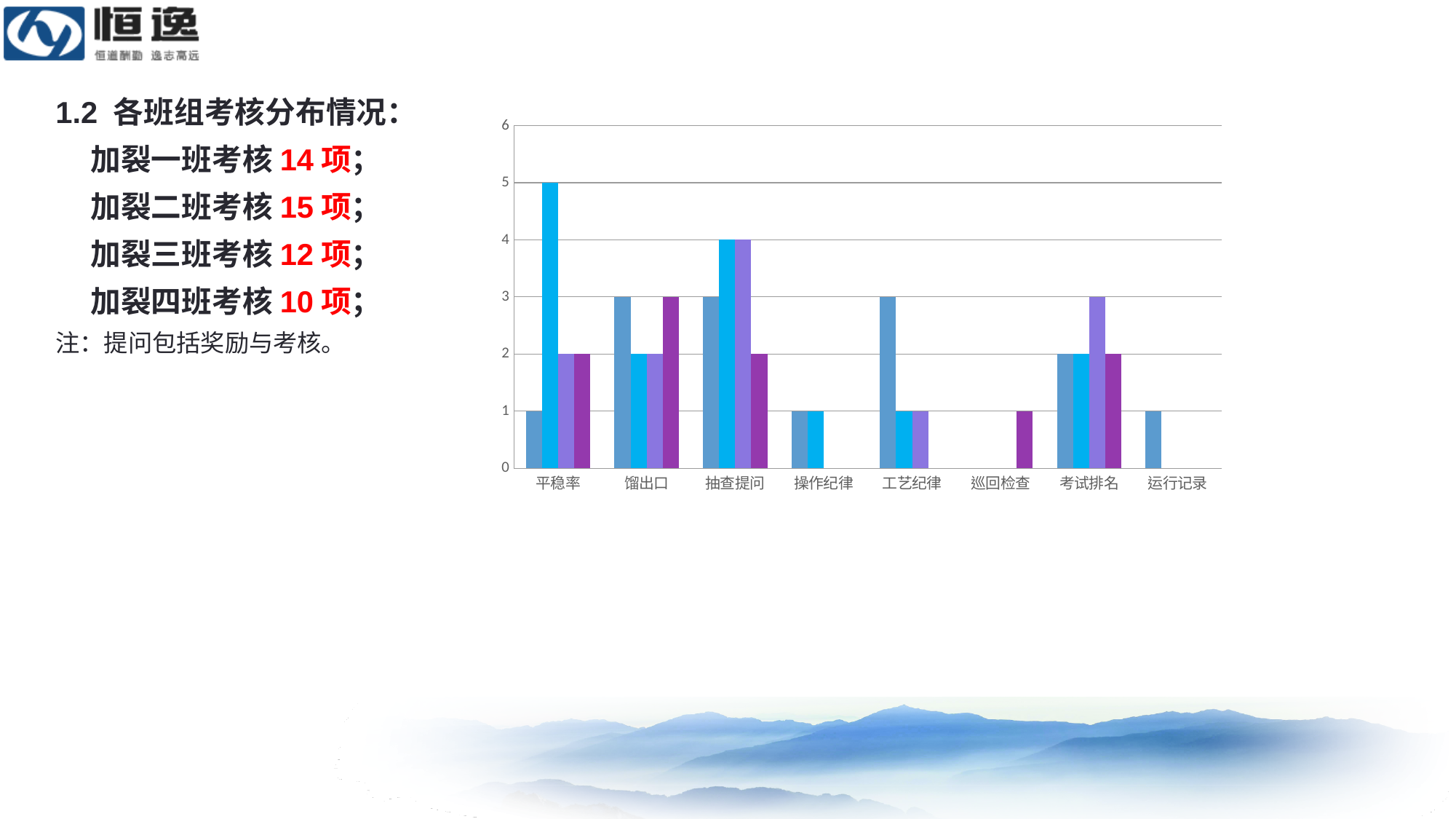
What is the value of the only bar shown in the 巡回检查 group? 1 What is the value of the first (steel blue) bar in the 工艺纪律 group? 3 What kind of chart is shown on the slide? bar chart How many categories are shown on the x axis of the chart? 8 What is the highest value reached by any bar in the chart, and in which category does it occur? 5, in 平稳率 Does the chart include a legend identifying the bar series? No What is the value of the tallest (cyan, second) bar in the 平稳率 group? 5 Is the value of the cyan (second) bar in the 平稳率 group greater or less than 4? greater What is the maximum value shown on the y axis of the chart? 6 What is the value of the only bar shown in the 运行记录 group? 1 What is the value of the third (lavender) bar in the 考试排名 group? 3 Which is larger: the first (steel blue) bar in 抽查提问 or the first (steel blue) bar in 操作纪律? 抽查提问